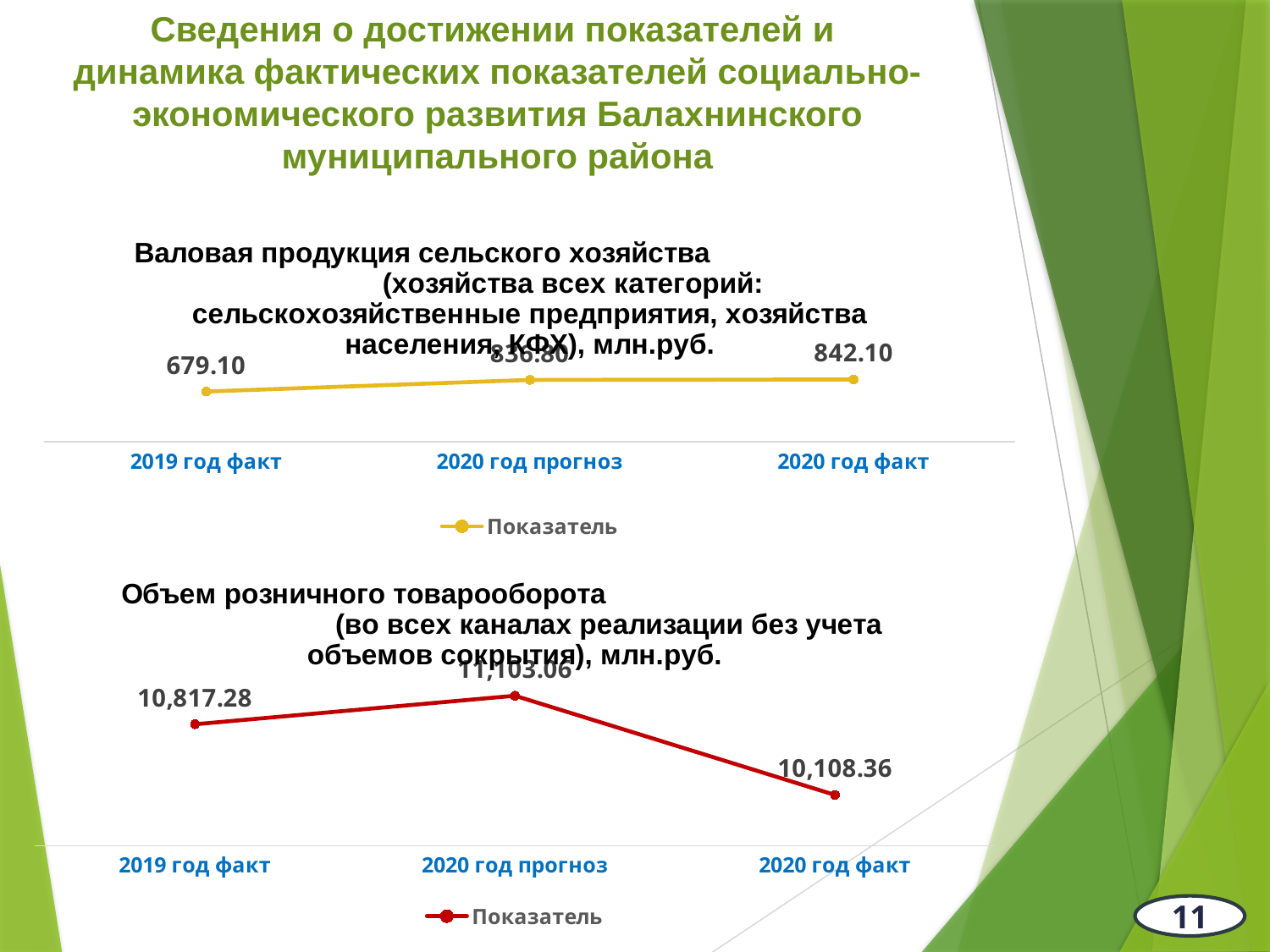
On the bottom chart (Объем розничного товарооборота), which is larger: the value for 2019 год факт or 2020 год факт? 2019 год факт On the bottom chart (Объем розничного товарооборота), which category has the lowest value? 2020 год факт On the top chart (Валовая продукция сельского хозяйства), which category has the lowest value? 2019 год факт On the top chart (Валовая продукция сельского хозяйства), do the values rise or fall from 2019 год факт to 2020 год факт? rise On the top chart (Валовая продукция сельского хозяйства), what is the value for 2019 год факт? 679.10 On the bottom chart (Объем розничного товарооборота), what is the value for 2020 год факт? 10,108.36 On the bottom chart (Объем розничного товарооборота), what is the difference between the 2019 год факт and 2020 год факт values? 708.92 On the bottom chart (Объем розничного товарооборота), which category has the highest value? 2020 год прогноз What kind of chart is the bottom chart (Объем розничного товарооборота)? line chart On the bottom chart (Объем розничного товарооборота), what is the value for 2019 год факт? 10,817.28 On the top chart (Валовая продукция сельского хозяйства), what is the value for 2020 год факт? 842.10 On the top chart (Валовая продукция сельского хозяйства), what is the difference between the 2020 год факт and 2019 год факт values? 163.00